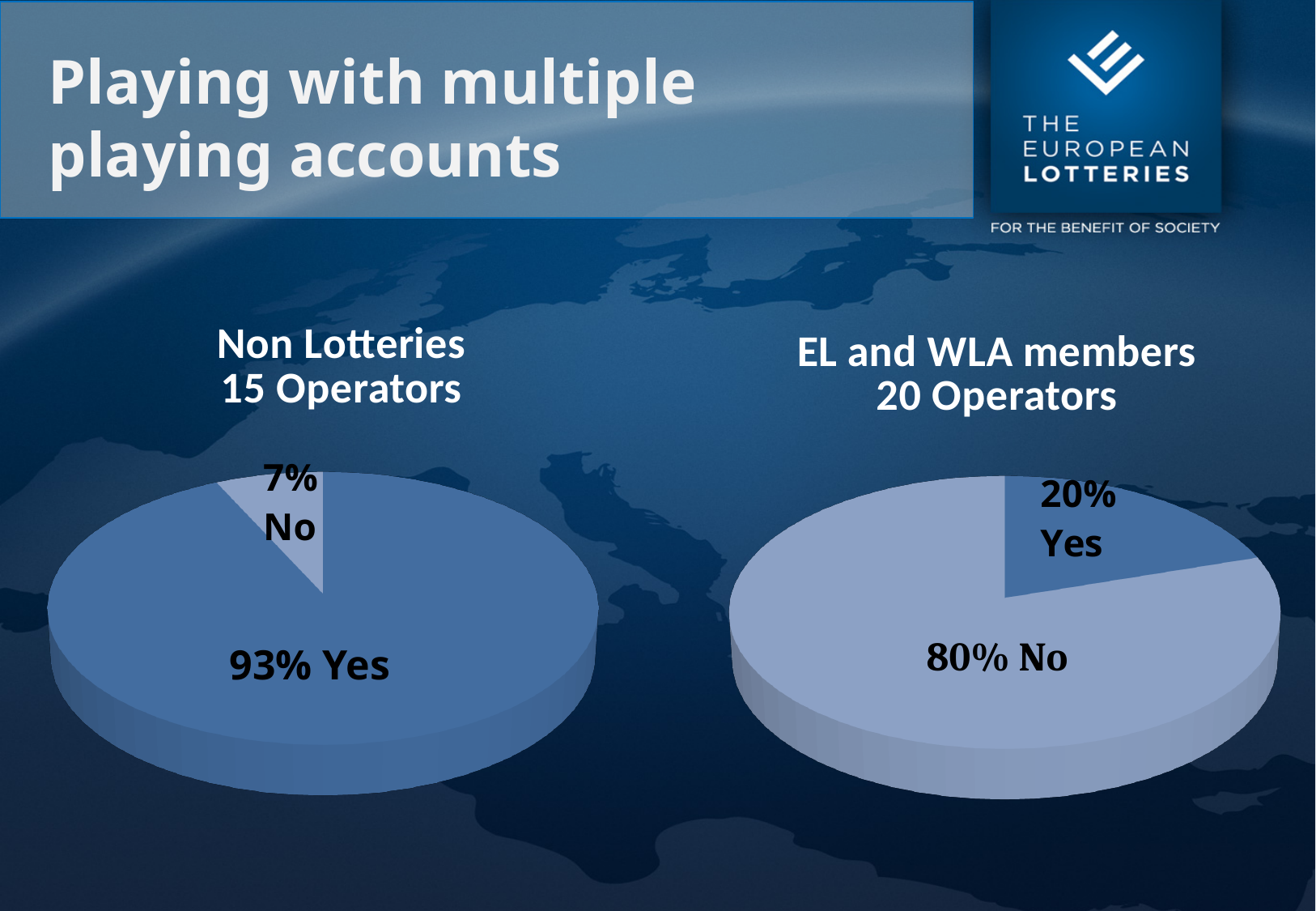
What kind of chart is used for the Non Lotteries data? Pie chart In the EL and WLA members chart, which answer has the smallest slice? Yes In the EL and WLA members chart, what share of operators answered No? 80% In the Non Lotteries chart, what share of operators answered No? 7% In the Non Lotteries chart, what share of operators answered Yes? 93% Which is larger: the Yes share in the Non Lotteries chart or the Yes share in the EL and WLA members chart? Non Lotteries How many operators are covered by the Non Lotteries chart? 15 How many operators are covered by the EL and WLA members chart? 20 In the EL and WLA members chart, what share of operators answered Yes? 20% In the Non Lotteries chart, which answer has the largest slice? Yes How many slices does the EL and WLA members pie chart have? 2 In the EL and WLA members chart, what is the difference between the No and Yes shares? 60%